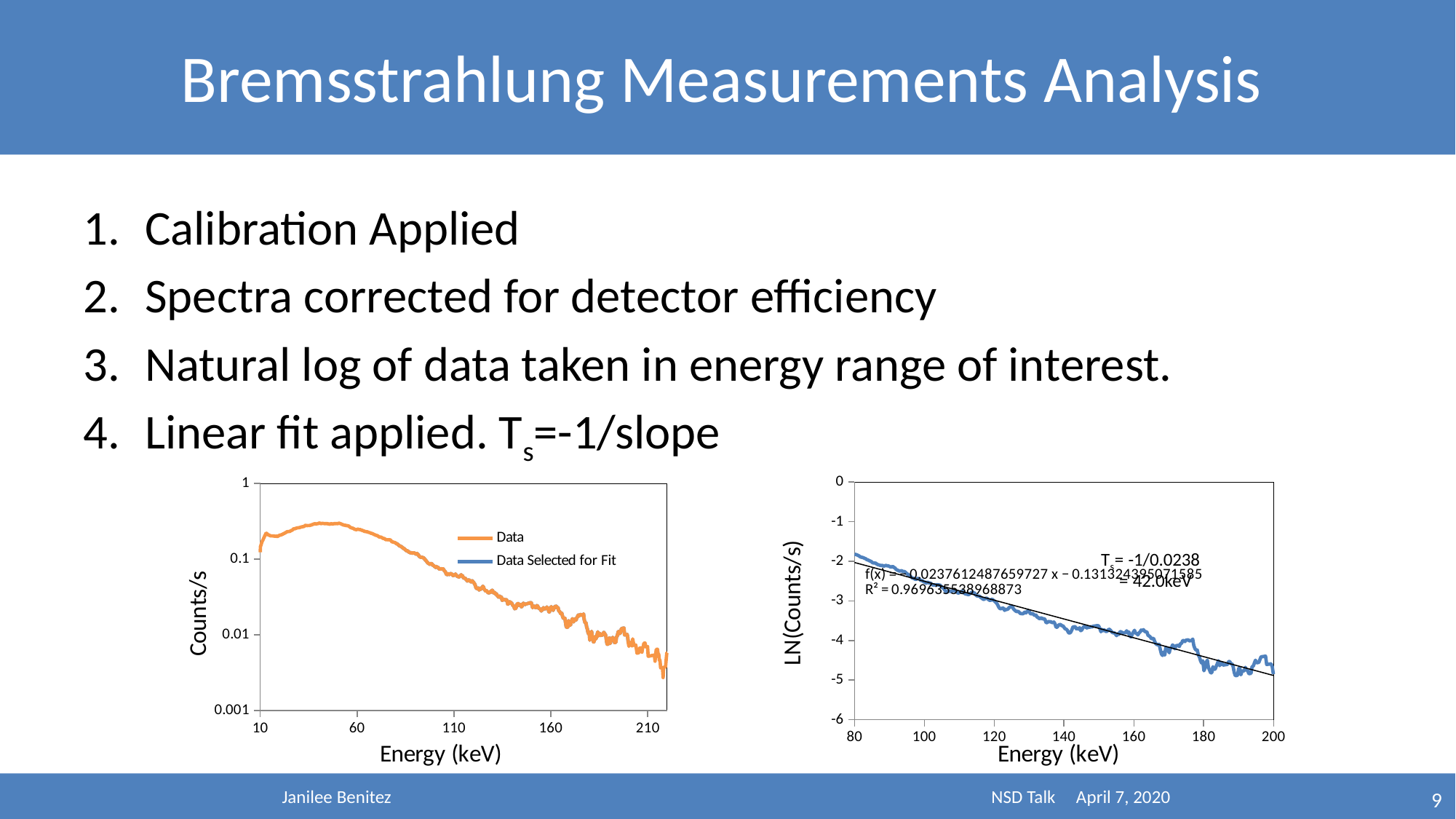
What kind of chart is the left chart (Counts/s vs Energy)? line chart On the right chart, is the value at 180 keV greater or less than -4? less On the right chart, what value of Ts is printed? 42.0keV On the left chart, is the value at 60 keV greater or less than 0.1 Counts/s? greater On the left chart, is the value at 210 keV greater or less than 0.1 Counts/s? less On the left chart, do the values rise or fall along the x axis between 60 keV and 210 keV? fall On the right chart, what R² value is printed for the linear fit? 0.969635538968873 On the right chart (LN(Counts/s) vs Energy), do the values rise or fall as energy increases from 80 to 200 keV? fall On the left chart, what is the y-axis label? Counts/s What are the two legend entries on the left chart? Data; Data Selected for Fit How many series does the legend of the left chart list? 2